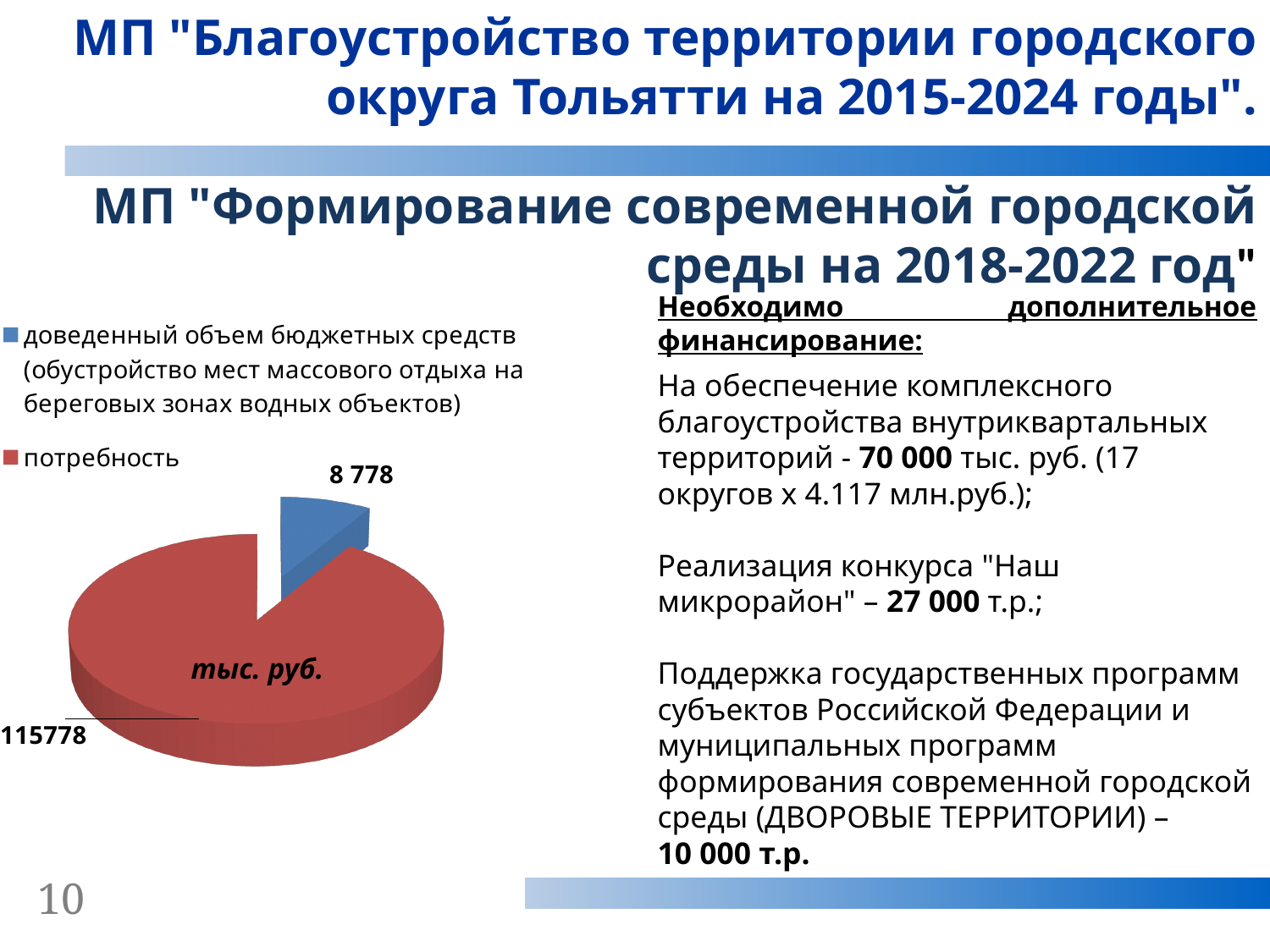
What is the difference between "потребность" and "доведенный объем бюджетных средств" in the pie chart? 107 000 Which is larger in the pie chart: "потребность" or "доведенный объем бюджетных средств"? потребность How many entries does the legend of the pie chart list? 2 Which slice of the pie chart is the largest? потребность What is the value for "потребность" in the pie chart? 115778 What is the value for "доведенный объем бюджетных средств" in the pie chart? 8 778 What unit is indicated on the pie chart? тыс. руб. Which slice of the pie chart is the smallest? доведенный объем бюджетных средств (обустройство мест массового отдыха на береговых зонах водных объектов) What colour is the "потребность" slice in the pie chart? red What is the total of the two values shown in the pie chart? 124 556 How many slices does the pie chart have? 2 What kind of chart is shown on the slide? pie chart